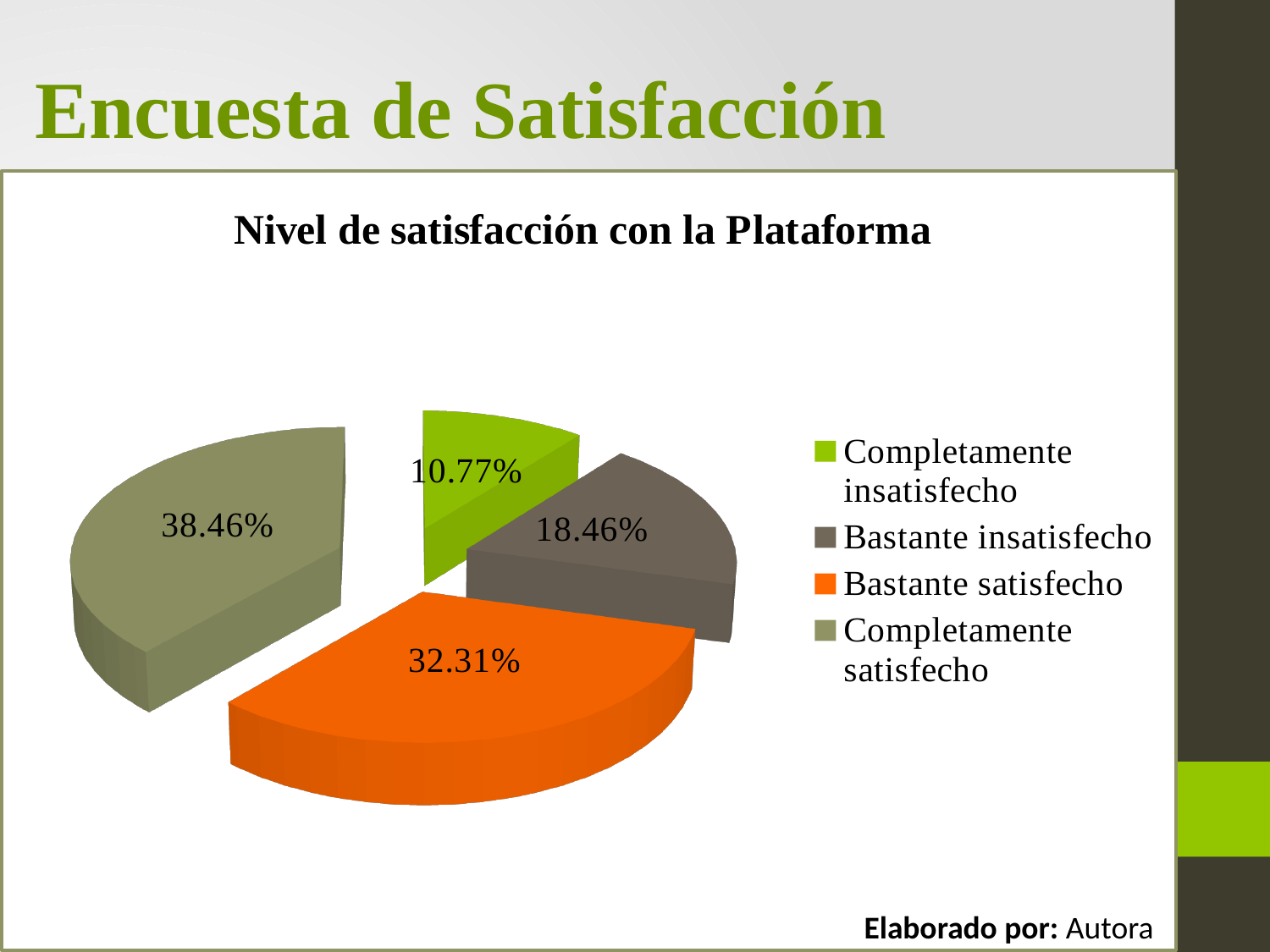
What colour is the slice for 'Bastante satisfecho'? orange What kind of chart is shown on the slide? pie chart Which is larger, the share for 'Bastante satisfecho' or the share for 'Bastante insatisfecho'? Bastante satisfecho Which category has the largest share of the pie? Completamente satisfecho What percentage of the pie is labelled 'Bastante satisfecho'? 32.31% What percentage of the pie is labelled 'Bastante insatisfecho'? 18.46% What is the difference in percentage points between 'Completamente satisfecho' and 'Completamente insatisfecho'? 27.69 Which category has the smallest share of the pie? Completamente insatisfecho How many categories does the legend list? 4 What is the title of the chart? Nivel de satisfacción con la Plataforma What percentage of the pie is labelled 'Completamente insatisfecho'? 10.77% What percentage of the pie is labelled 'Completamente satisfecho'? 38.46%